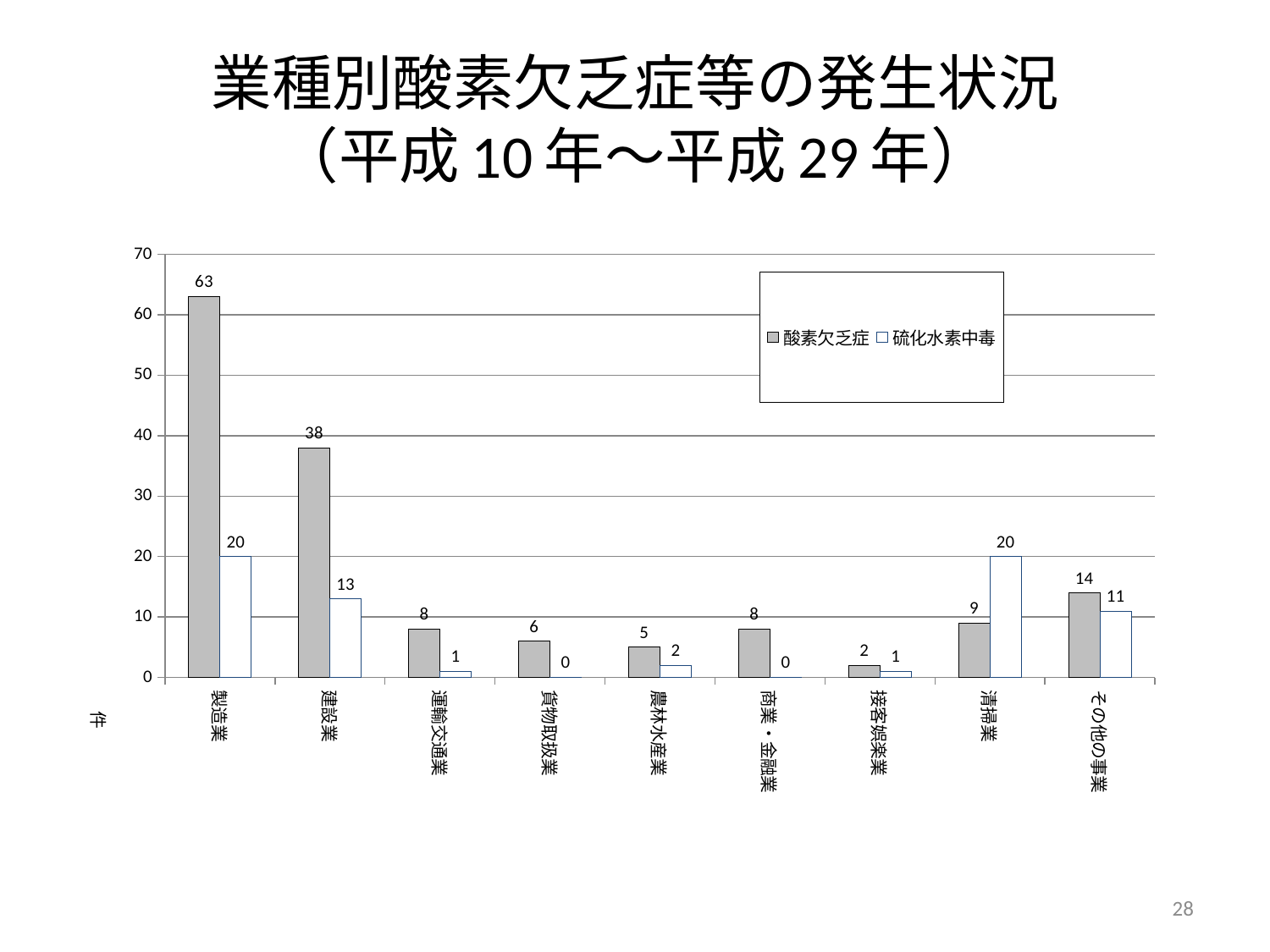
What kind of chart is shown on the slide? bar chart What is the value of 酸素欠乏症 for 製造業? 63 What is the value of 硫化水素中毒 for 清掃業? 20 What is the difference between the 酸素欠乏症 values for 製造業 and 建設業? 25 How many categories are shown on the x axis? 9 Which is larger for 清掃業: 酸素欠乏症 or 硫化水素中毒? 硫化水素中毒 What are the two series listed in the legend? 酸素欠乏症 and 硫化水素中毒 What is the value of 硫化水素中毒 for 建設業? 13 Which category has the highest value for 酸素欠乏症? 製造業 How many series does the legend list? 2 What is the total of 酸素欠乏症 and 硫化水素中毒 for その他の事業? 25 Which category has the lowest value for 酸素欠乏症? 接客娯楽業